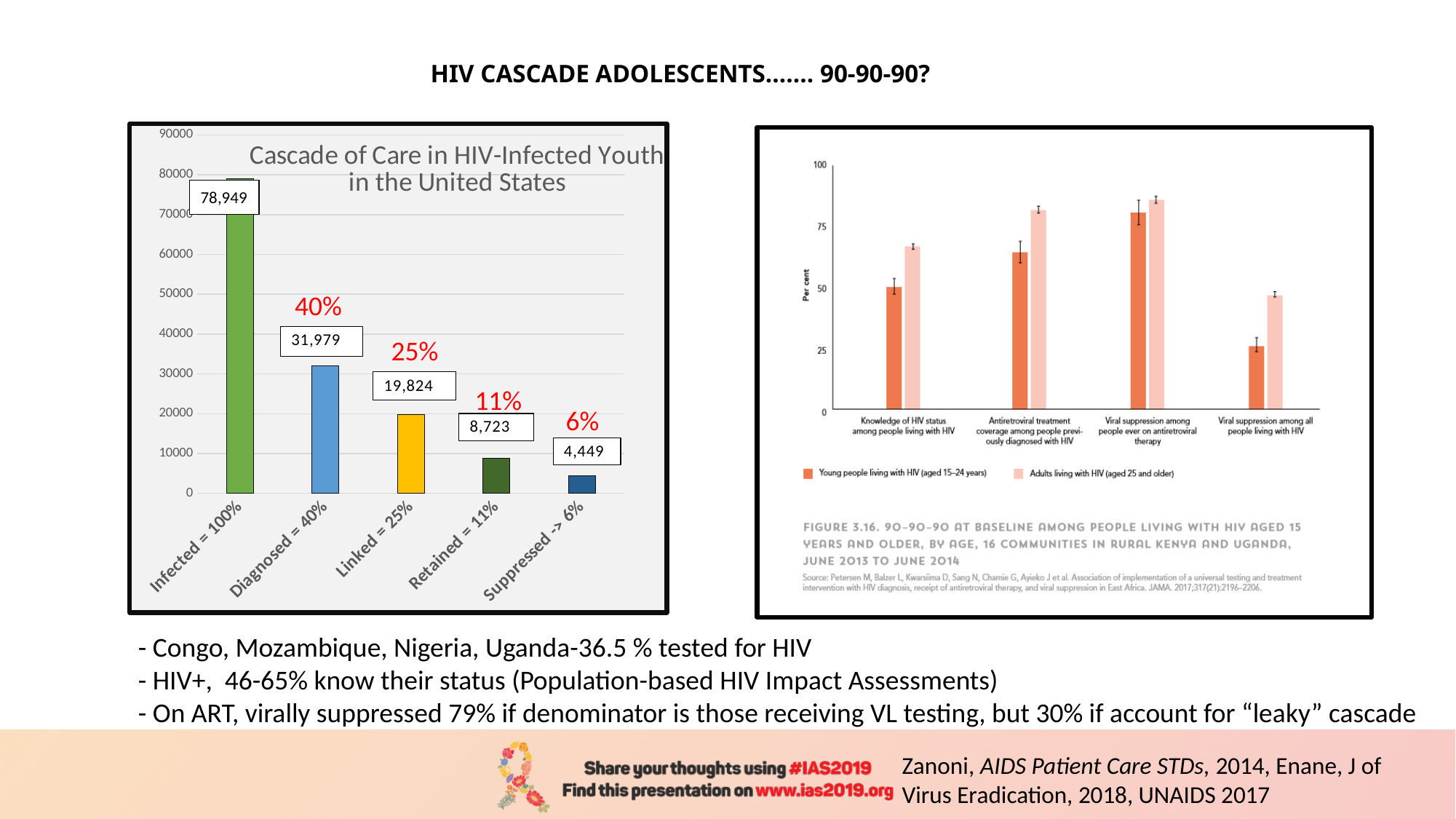
In the chart on the right (Figure 3.16, 90-90-90 at baseline), for 'Knowledge of HIV status among people living with HIV', which is larger: young people or adults? Adults living with HIV (aged 25 and older) In the 'Cascade of Care in HIV-Infected Youth in the United States' chart, what is the value for 'Suppressed -> 6%'? 4,449 In the 'Cascade of Care in HIV-Infected Youth in the United States' chart, what is the value for 'Linked = 25%'? 19,824 In the chart on the right (Figure 3.16, 90-90-90 at baseline), how many series does the legend list? 2 In the chart on the right (Figure 3.16, 90-90-90 at baseline), how many categories are shown on the x axis? 4 In the 'Cascade of Care in HIV-Infected Youth in the United States' chart, which category has the lowest value? Suppressed -> 6% What kind of chart is the 'Cascade of Care in HIV-Infected Youth in the United States' chart? bar chart In the 'Cascade of Care in HIV-Infected Youth in the United States' chart, how many categories are shown? 5 In the 'Cascade of Care in HIV-Infected Youth in the United States' chart, do the values rise or fall from left to right? fall In the 'Cascade of Care in HIV-Infected Youth in the United States' chart, what is the value for 'Infected = 100%'? 78,949 In the chart on the right (Figure 3.16, 90-90-90 at baseline), is the value for young people living with HIV for 'Viral suppression among all people living with HIV' greater or less than 50? less In the 'Cascade of Care in HIV-Infected Youth in the United States' chart, what is the difference between the 'Diagnosed = 40%' and 'Retained = 11%' values? 23,256